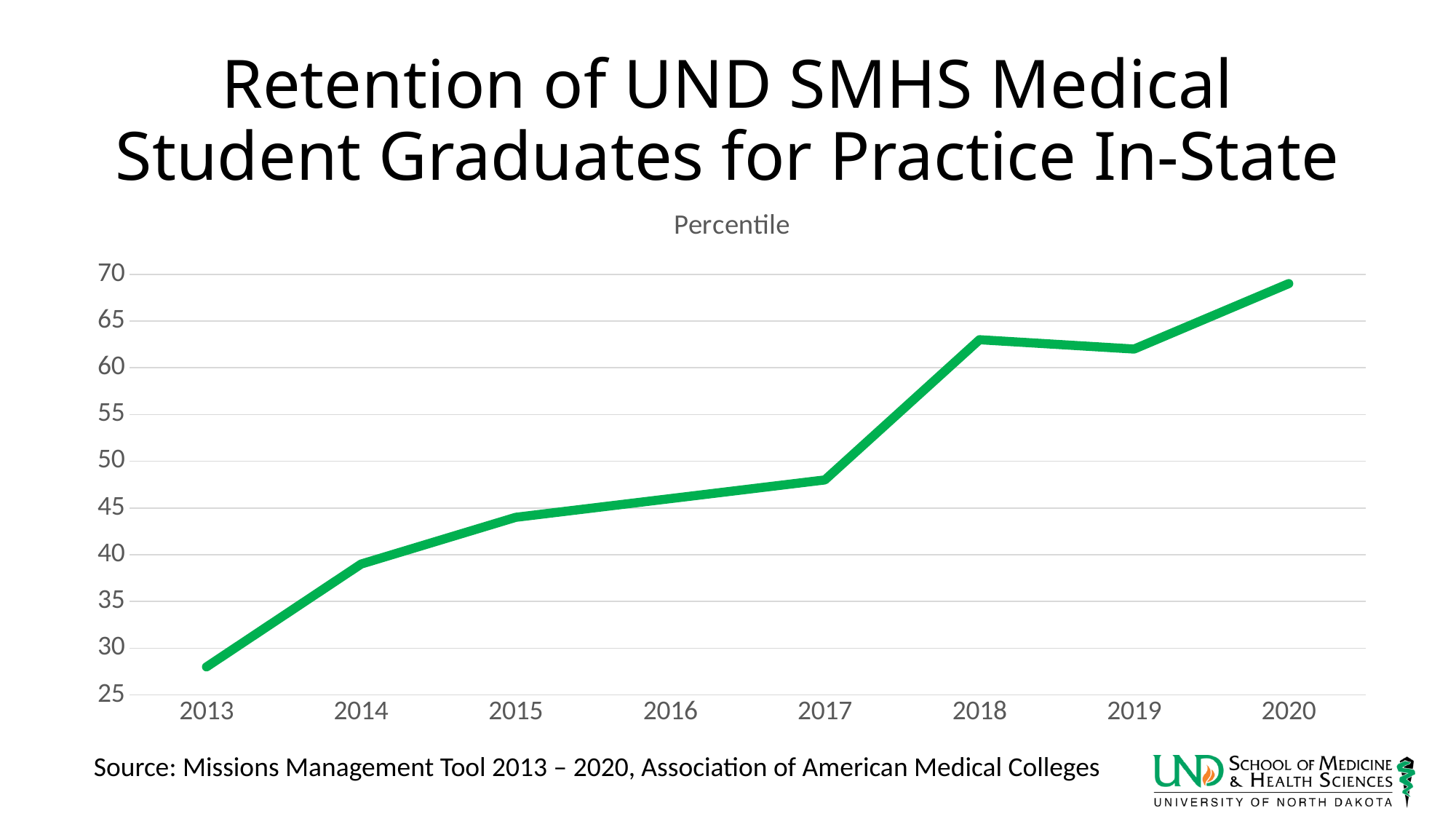
Overall, do the values rise or fall from 2013 to 2020? rise Which year has the highest percentile value? 2020 Is the value for 2013 greater or less than 30? less Is the value for 2018 greater or less than 60? greater Which year has the larger value, 2017 or 2018? 2018 What is the label shown above the chart area, under the main title? Percentile Which year has the lowest percentile value? 2013 Is the value for 2017 greater or less than 50? less How many years are plotted along the x axis? 8 What kind of chart is shown on the slide? line chart